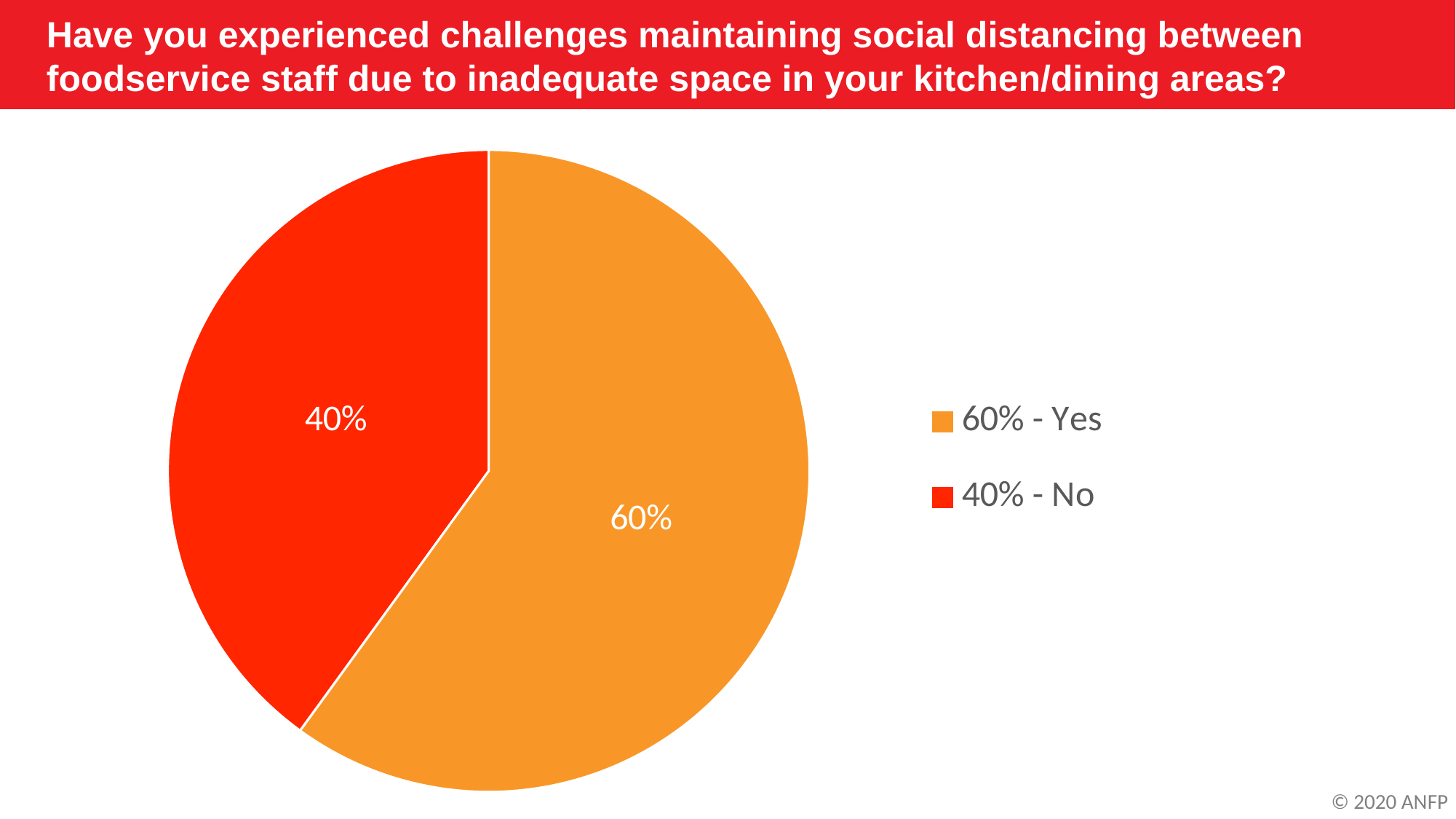
What kind of chart is shown on the slide? pie chart How many slices does the pie chart have? 2 What question does the chart title ask? Have you experienced challenges maintaining social distancing between foodservice staff due to inadequate space in your kitchen/dining areas? Which is larger, the share for Yes or the share for No? Yes What colour is the slice representing Yes? orange How many entries does the legend list? 2 What percentage of respondents answered No? 40% Which response has the smallest share of the pie? No What share of the pie does the No slice represent? 40% What is the difference in percentage points between the Yes and No responses? 20 Which response has the largest share of the pie? Yes What percentage of respondents answered Yes? 60%